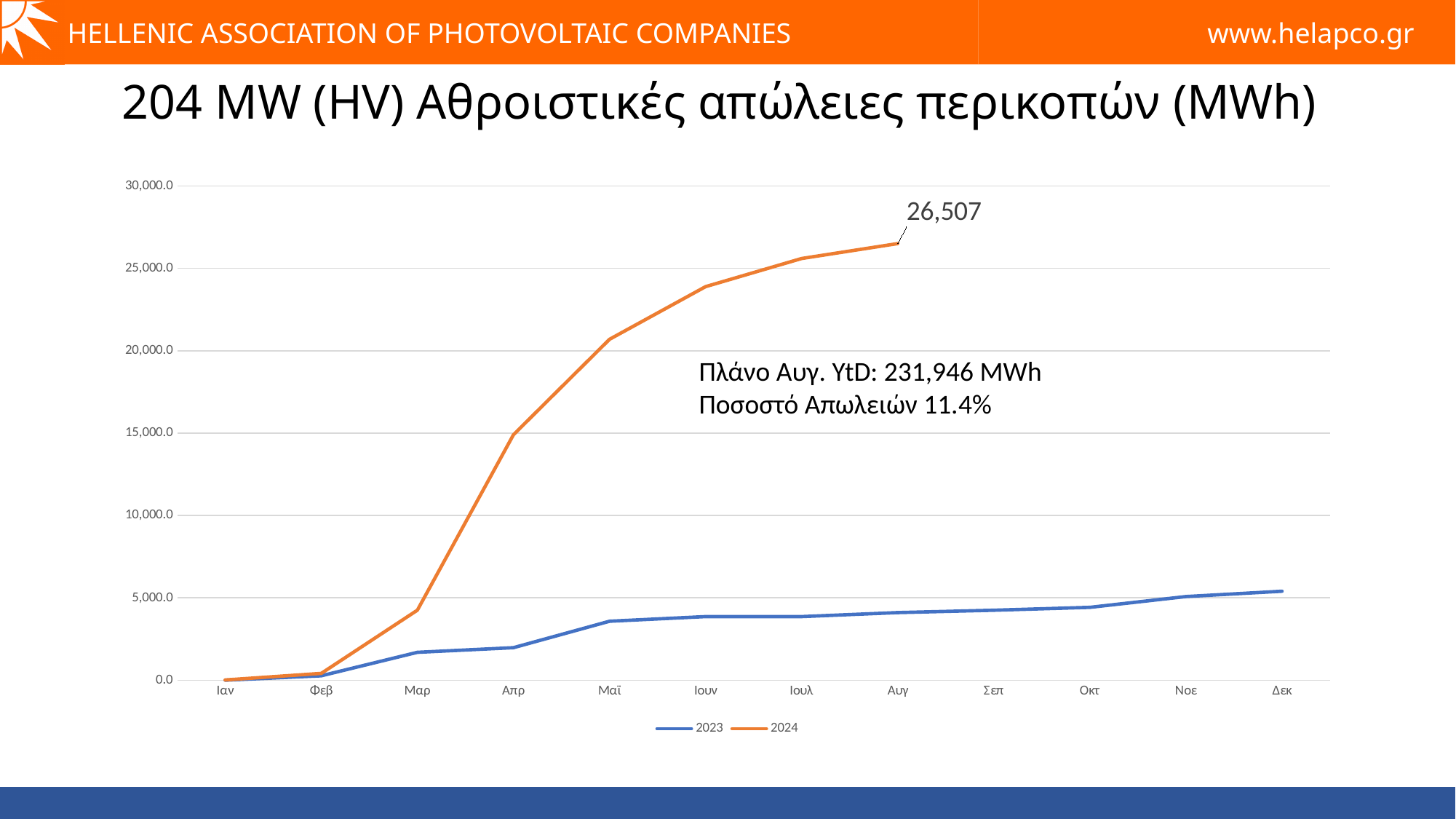
Does the 2024 line rise or fall from Ιαν to Αυγ? rise What are the two entries in the legend? 2023 and 2024 What is the labelled value of the 2024 series at Αυγ? 26,507 Is the 2024 value at Απρ greater or less than 10,000? greater At Μαϊ, which series has the higher value, 2023 or 2024? 2024 How many series does the legend list? 2 Is the 2024 value at Ιουν greater or less than 20,000? greater What colour is the 2024 line? orange What kind of chart is shown on the slide? line chart Up to which month does the 2024 series have data points? Αυγ Is the 2023 value at Δεκ greater or less than 10,000? less How many months are shown on the x axis? 12